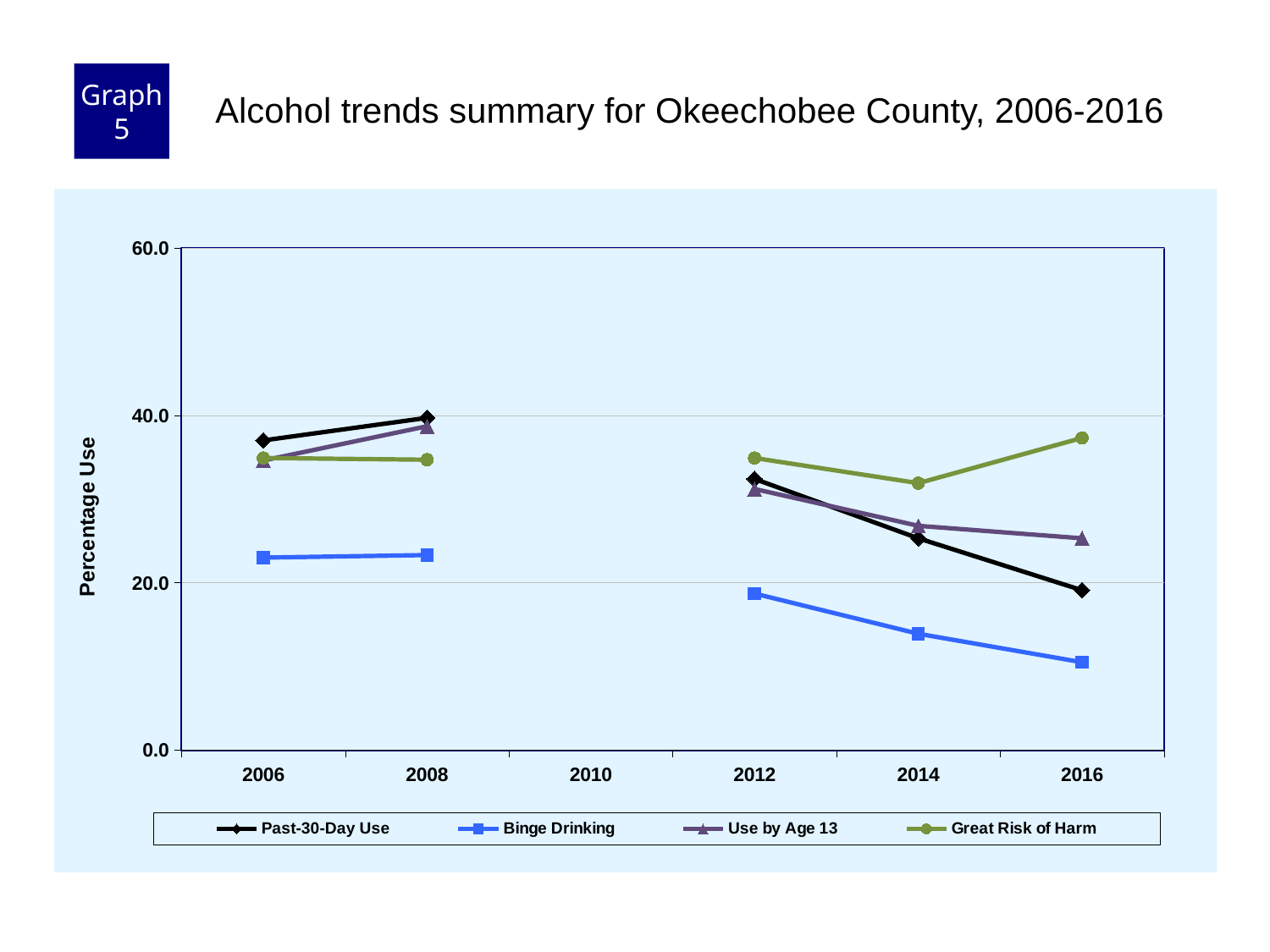
What is the title of the chart? Alcohol trends summary for Okeechobee County, 2006-2016 Is the value for Binge Drinking in 2016 greater or less than 20.0? less Does the Binge Drinking series rise or fall from 2012 to 2016? fall What kind of chart is shown on the slide? line chart Which series has the lowest value in 2014? Binge Drinking How many series does the legend list? 4 What is the label on the vertical axis? Percentage Use In 2006, which is larger: Past-30-Day Use or Binge Drinking? Past-30-Day Use How many years have data points plotted for the Past-30-Day Use series? 5 Is the value for Past-30-Day Use in 2012 greater or less than 40.0? less Is the value for Use by Age 13 in 2016 greater or less than 20.0? greater Which series has the highest value in 2016? Great Risk of Harm